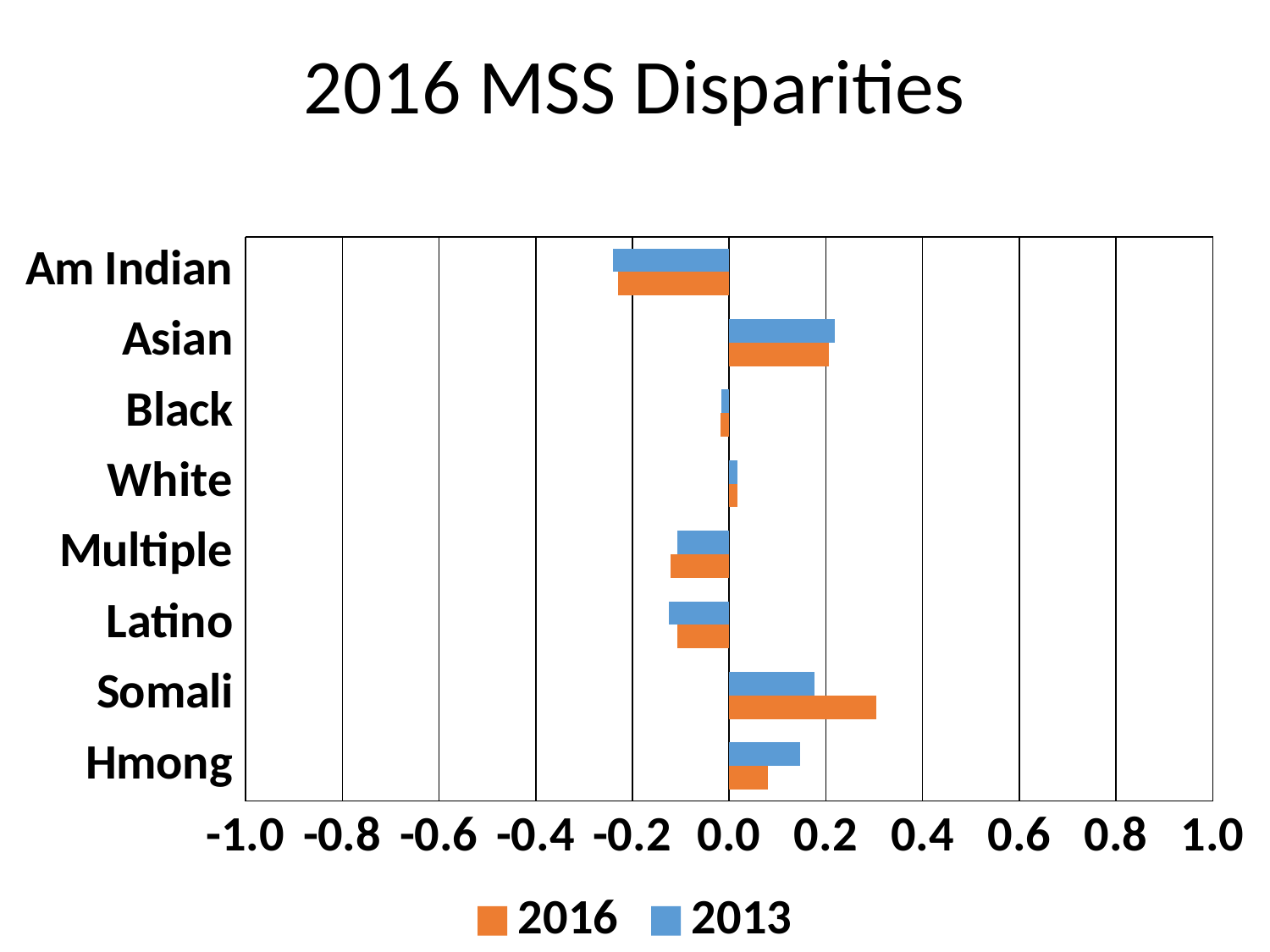
How many categories are shown on the chart? 8 Which category has the lowest 2016 value? Am Indian For Hmong, which is larger: the 2016 value or the 2013 value? 2013 For Somali, which is larger: the 2016 value or the 2013 value? 2016 Is the 2016 value for Am Indian greater or less than -0.2? less What is the title of the chart? 2016 MSS Disparities Is the 2016 value for Somali greater or less than 0.2? greater Which category has the highest 2016 value? Somali Which category has the lowest 2013 value? Am Indian What kind of chart is shown on the slide? bar chart Which colour represents the 2016 series? orange How many series does the legend list? 2